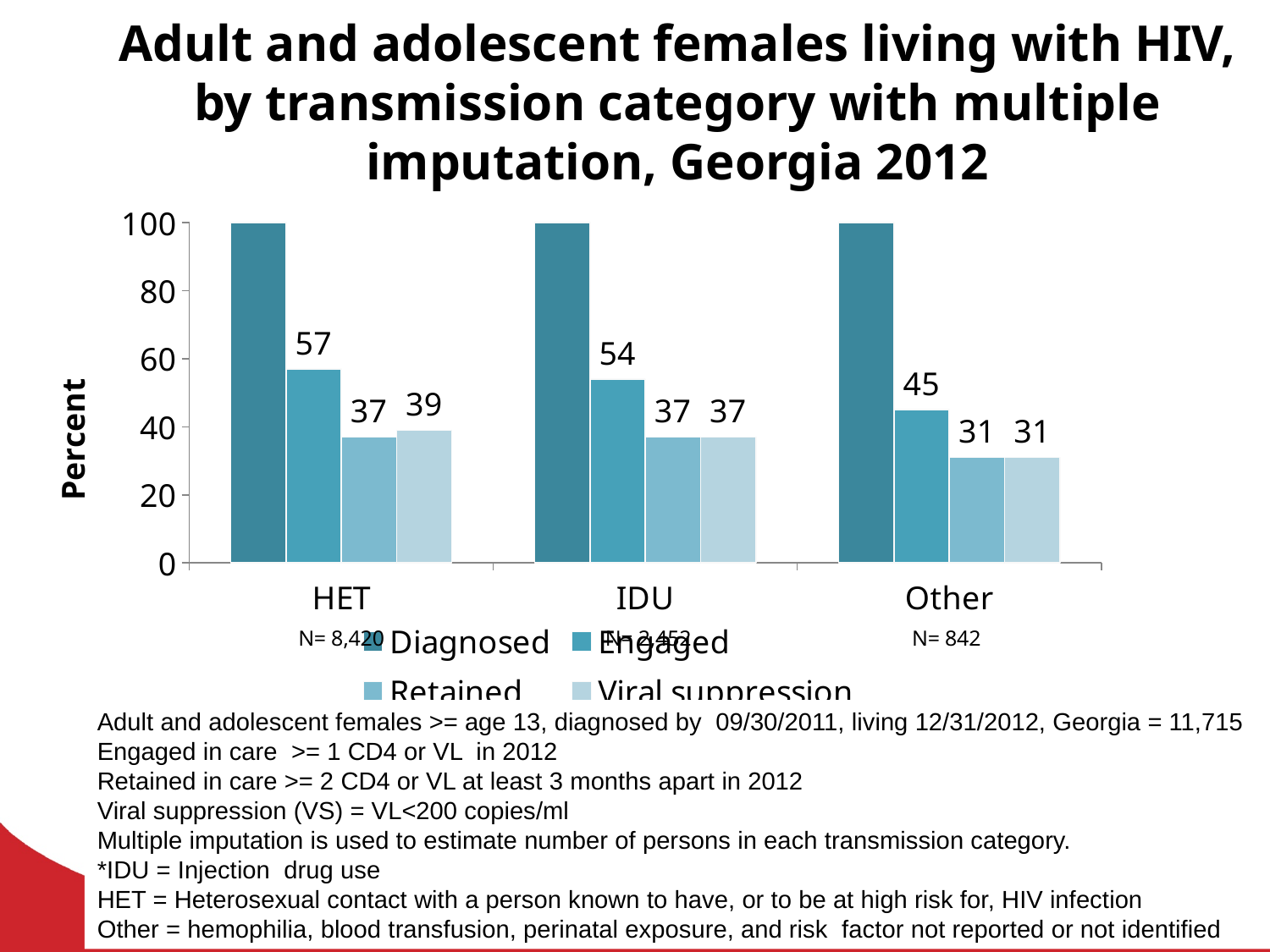
Is the Diagnosed value for HET greater or less than 80? greater What is the difference between the Engaged values for HET and Other? 12 How many transmission categories are shown on the x axis? 3 What is the Engaged value for HET? 57 What is the Retained value for Other? 31 Which transmission category has the lowest Viral suppression value? Other What kind of chart is shown on the slide? Bar chart Is the Engaged value for IDU larger than the Engaged value for Other? Yes What is the Engaged value for Other? 45 How many series does the legend list? 4 Which transmission category has the highest Engaged value? HET What is the Viral suppression value for IDU? 37